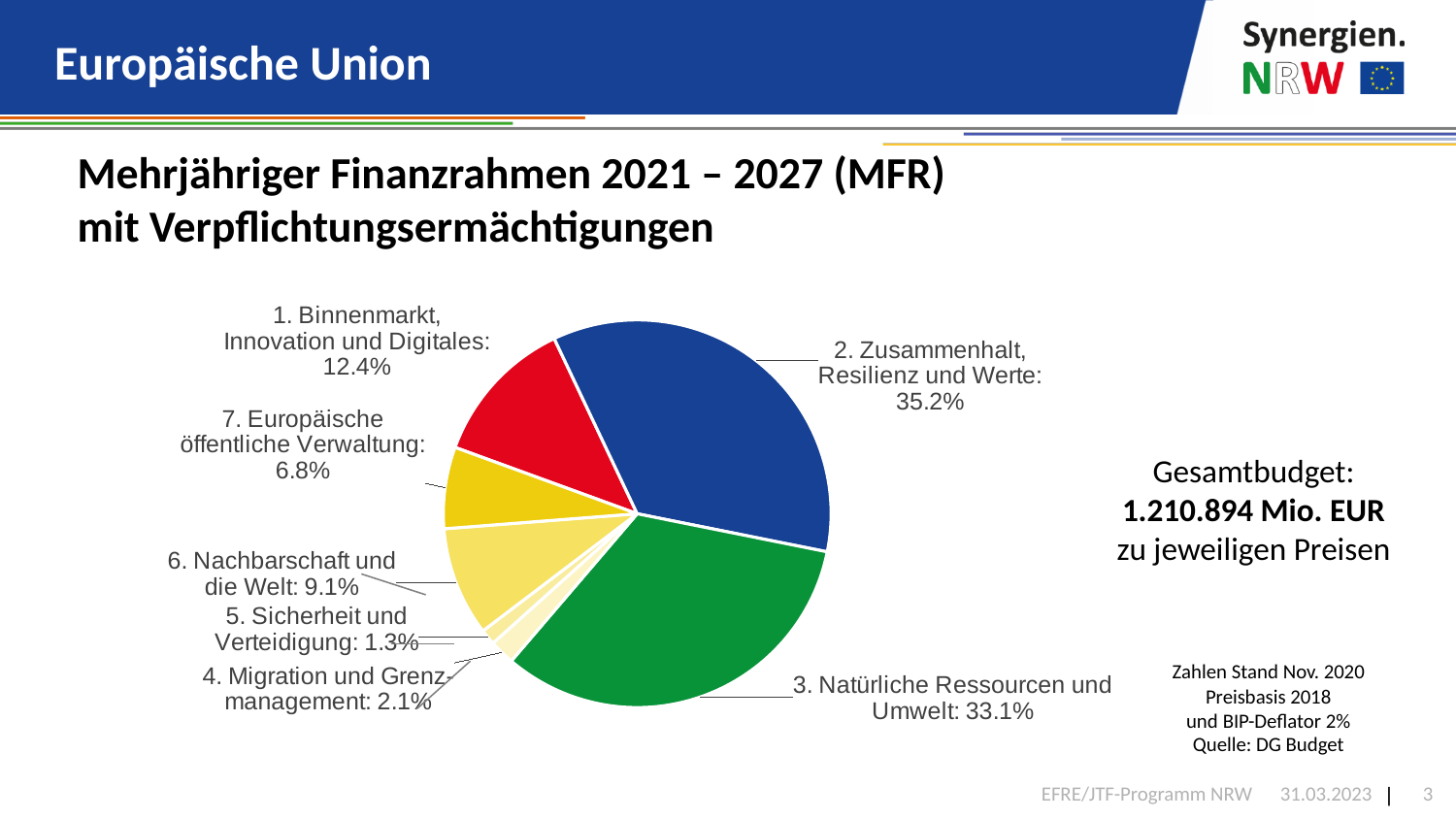
Which is larger: '4. Migration und Grenzmanagement' or '5. Sicherheit und Verteidigung'? 4. Migration und Grenzmanagement What is the value shown for '1. Binnenmarkt, Innovation und Digitales'? 12.4% What is the value shown for '7. Europäische öffentliche Verwaltung'? 6.8% What is the difference in percentage points between '2. Zusammenhalt, Resilienz und Werte' and '3. Natürliche Ressourcen und Umwelt'? 2.1 Which category has the smallest slice of the pie? 5. Sicherheit und Verteidigung What kind of chart is shown on the slide? pie chart How many slices does the pie chart have? 7 What share of the pie is '2. Zusammenhalt, Resilienz und Werte'? 35.2% What is the value shown for '3. Natürliche Ressourcen und Umwelt'? 33.1% What total budget is stated next to the pie chart? 1.210.894 Mio. EUR What is the value shown for '6. Nachbarschaft und die Welt'? 9.1% Which category has the largest slice of the pie? 2. Zusammenhalt, Resilienz und Werte